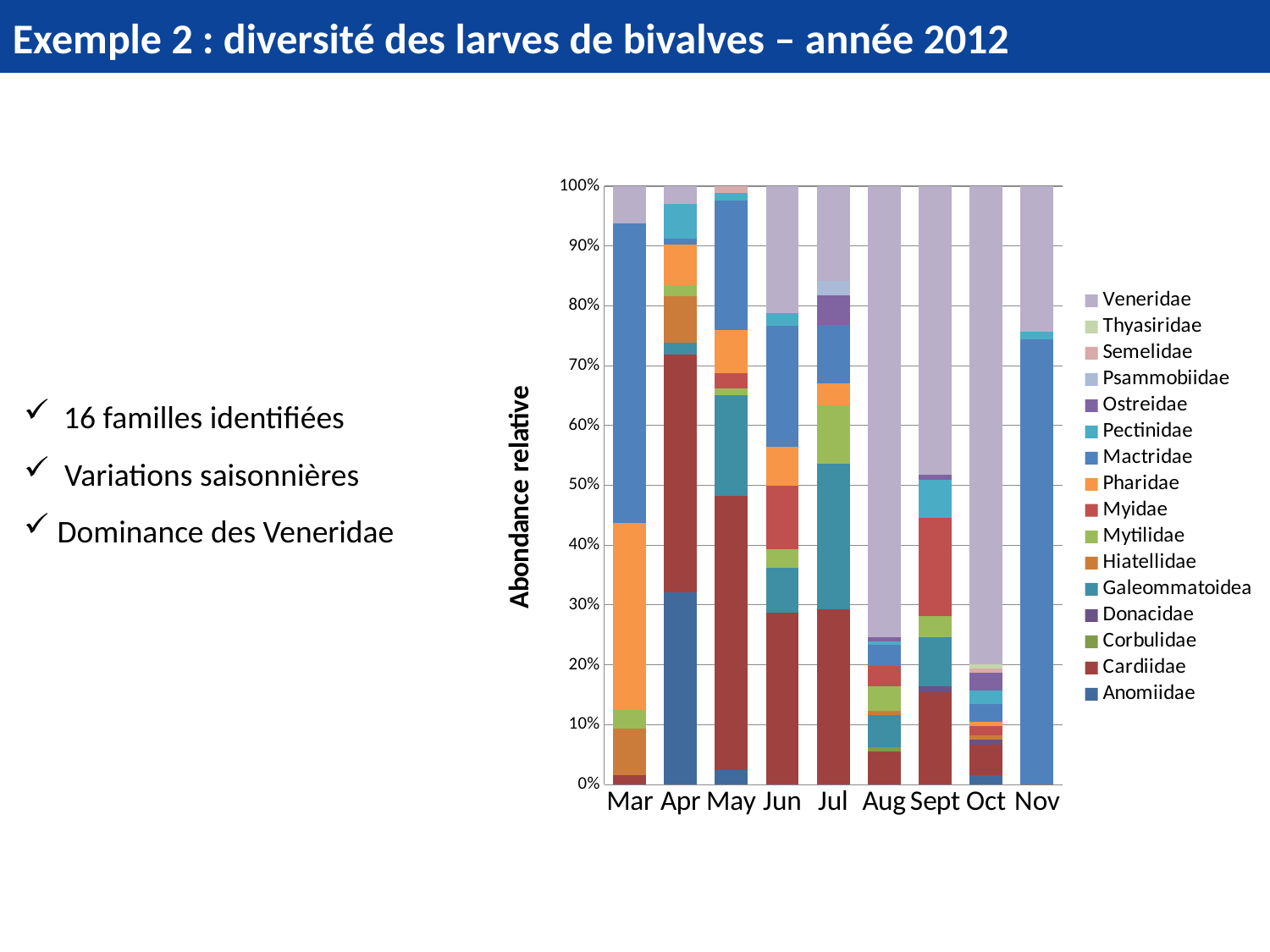
Which is larger, the Veneridae share in Aug or the Veneridae share in Mar? Aug What is the total height of each stacked bar in the chart? 100% Which family is listed first (at the top) in the chart legend? Veneridae What kind of chart is shown on the slide? stacked bar chart Is the Veneridae share in Nov greater or less than 30%? less Is the Cardiidae share in Apr greater or less than 30%? greater Is the Mactridae share in Nov greater or less than 70%? greater How many families (series) does the chart legend list? 16 Which month has the largest Mactridae share? Nov How many months are shown along the x axis of the chart? 9 What is the label of the vertical axis of the chart? Abondance relative